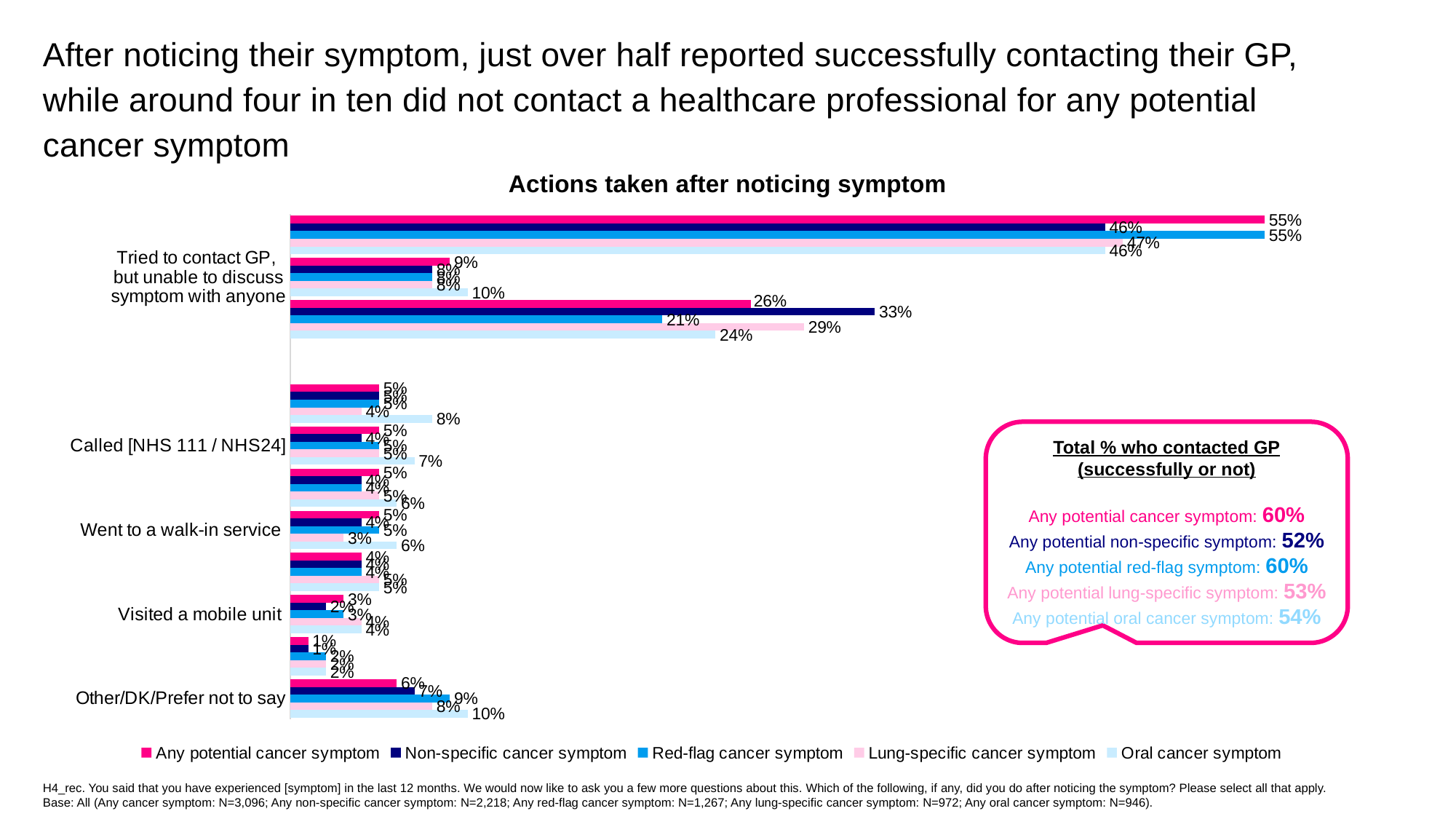
For 'Visited a mobile unit', what is the value for the Oral cancer symptom series? 4% What is the title of the chart? Actions taken after noticing symptom According to the callout box, what is the total % who contacted GP (successfully or not) for any potential cancer symptom? 60% For 'Other/DK/Prefer not to say', which is larger: the Red-flag cancer symptom value or the Non-specific cancer symptom value? Red-flag cancer symptom For 'Other/DK/Prefer not to say', what is the value for the Any potential cancer symptom series? 6% For 'Tried to contact GP, but unable to discuss symptom with anyone', what is the value for the Oral cancer symptom series? 10% How many series does the legend of the chart list? 5 What kind of chart is shown on the slide? Bar chart For 'Other/DK/Prefer not to say', which series has the highest value? Oral cancer symptom For 'Other/DK/Prefer not to say', what is the value for the Oral cancer symptom series? 10% For 'Other/DK/Prefer not to say', what is the difference between the Oral cancer symptom value and the Any potential cancer symptom value? 4 percentage points For 'Went to a walk-in service', what is the value for the Oral cancer symptom series? 6%